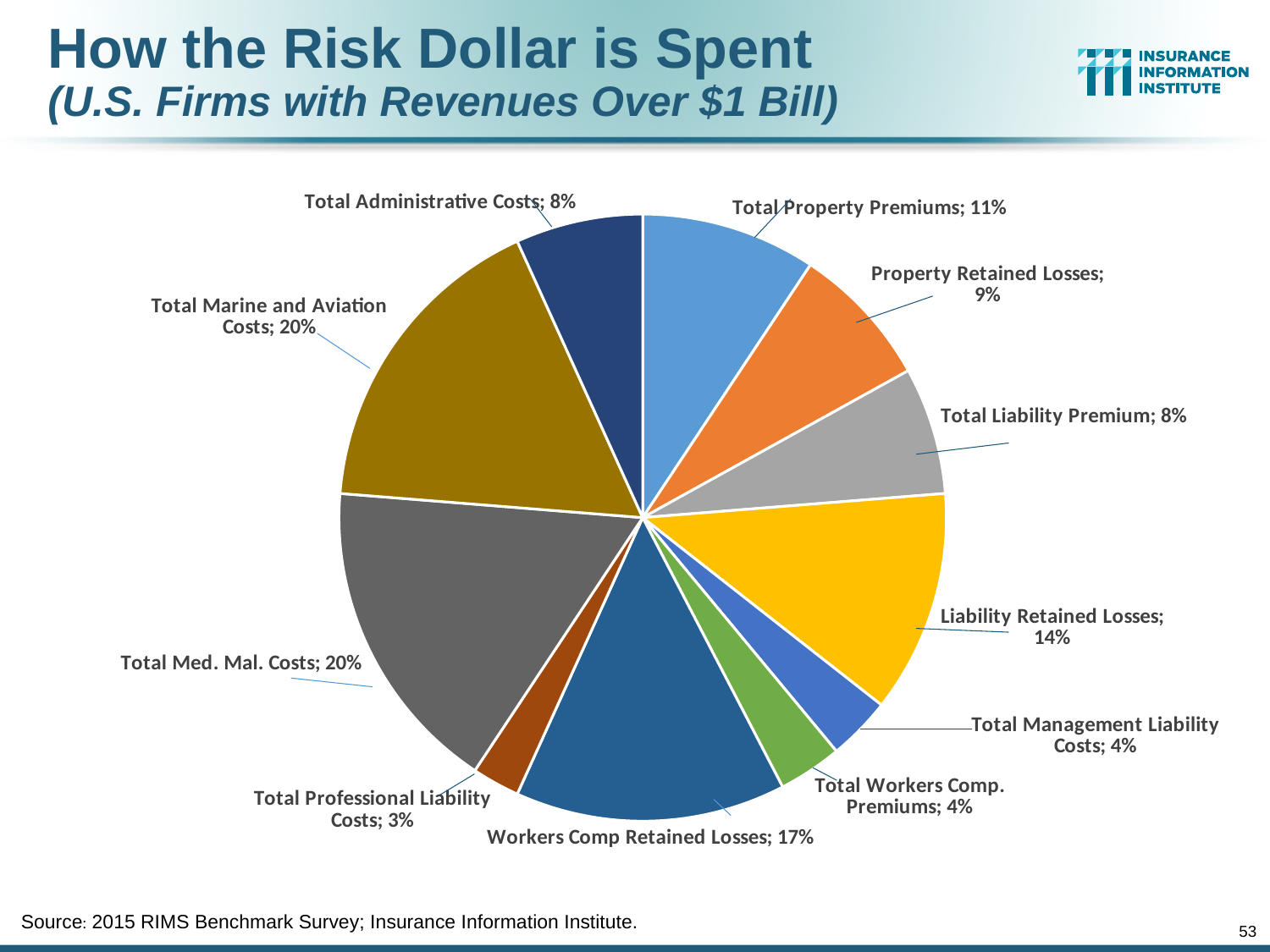
Which is larger, Property Retained Losses or Total Liability Premium? Property Retained Losses What kind of chart is shown on the slide? pie chart What is the value shown for Total Management Liability Costs? 4% What percentage is shown for Workers Comp Retained Losses? 17% How many slices does the pie chart have? 11 What is the difference between Workers Comp Retained Losses and Total Workers Comp. Premiums? 13% Which category has the smallest slice of the pie? Total Professional Liability Costs What is the difference between Total Marine and Aviation Costs and Total Administrative Costs? 12% What is the title of the chart on the slide? How the Risk Dollar is Spent (U.S. Firms with Revenues Over $1 Bill) What is the value shown for Liability Retained Losses? 14% What share of the risk dollar goes to Total Property Premiums? 11% What is the value for Total Med. Mal. Costs? 20%